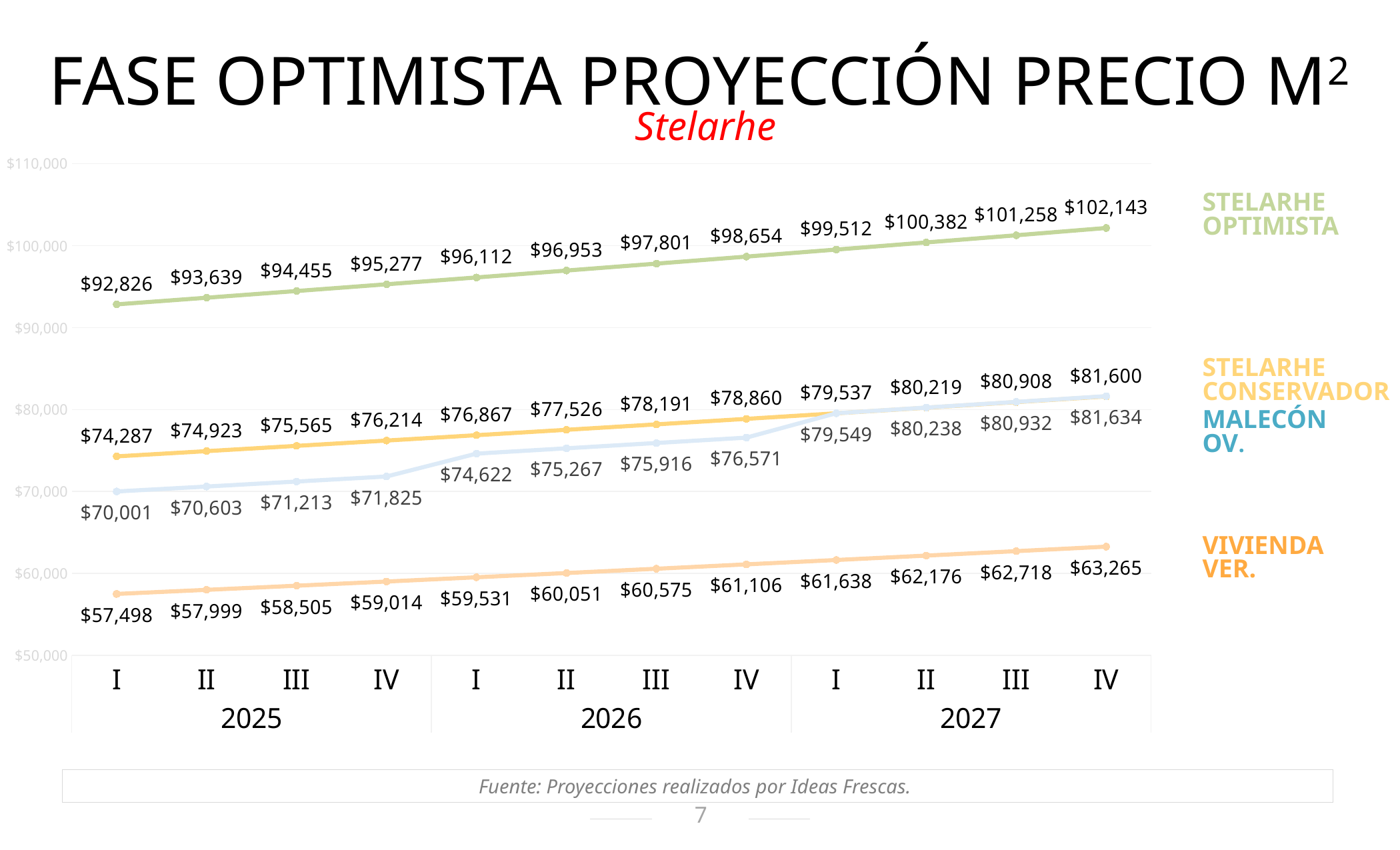
Is the value for Stelarhe Optimista in quarter IV of 2027 greater or less than $100,000? greater By how much does Stelarhe Optimista increase from quarter I of 2025 to quarter IV of 2027? $9,317 Which series has the lowest value in quarter I of 2025? Vivienda Ver. What is the value of Malecón OV. in quarter I of 2025? $70,001 Which series has the highest value in quarter IV of 2027? Stelarhe Optimista In quarter I of 2025, which is larger: Stelarhe Optimista or Vivienda Ver.? Stelarhe Optimista What is the value of Vivienda Ver. in quarter IV of 2027? $63,265 How many series does the chart show? 4 How many quarters are plotted along the x axis? 12 What is the value of Stelarhe Conservador in quarter IV of 2027? $81,600 What kind of chart is shown on the slide? line chart What is the value of Stelarhe Optimista in quarter I of 2025? $92,826